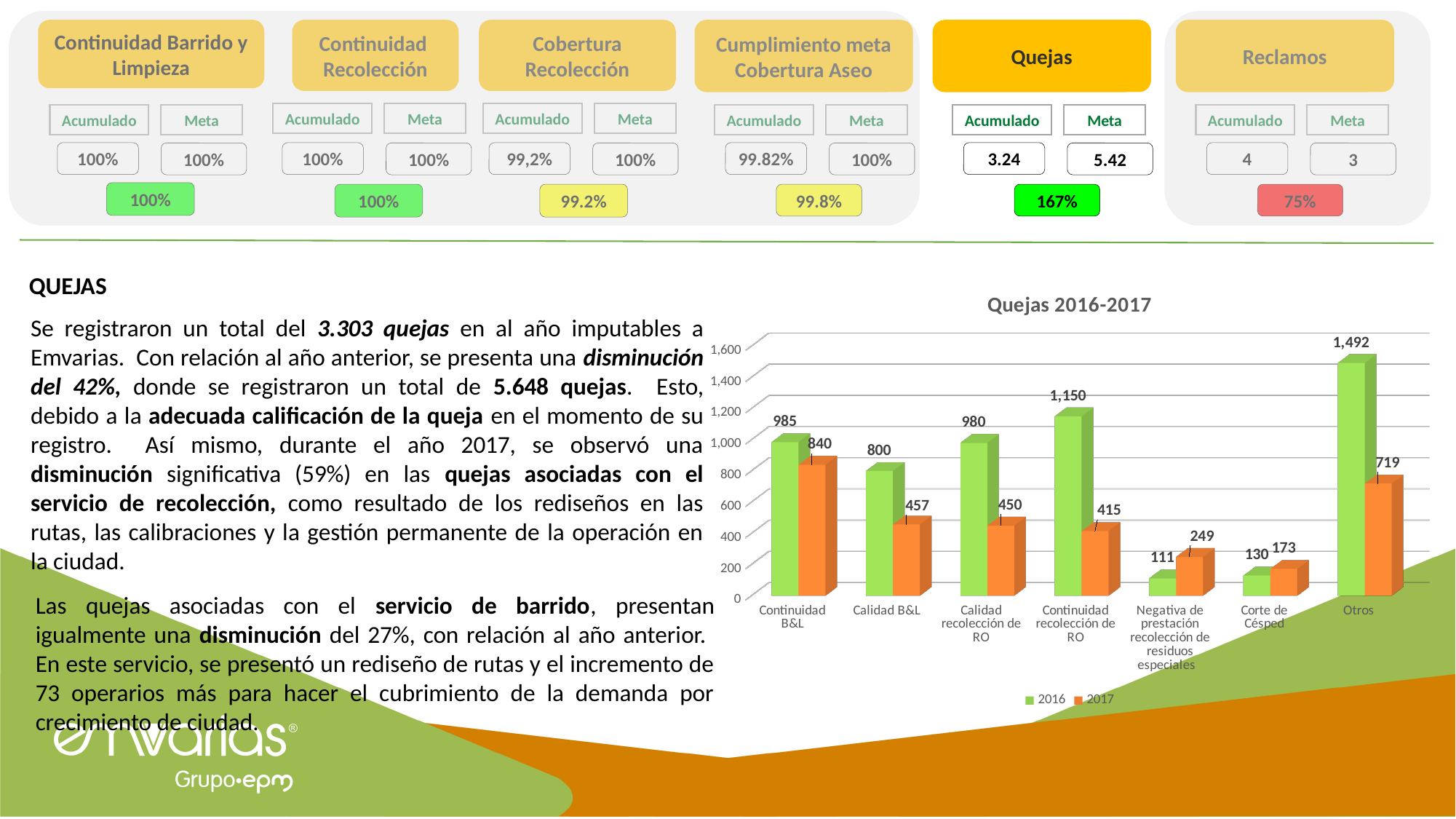
What is the difference between the 2016 values for Otros and Continuidad B&L in the Quejas 2016-2017 chart? 507 Which colour represents the 2017 series in the Quejas 2016-2017 chart? Orange What is the 2017 value for Calidad B&L in the Quejas 2016-2017 chart? 457 What is the 2016 value for Continuidad recolección de RO in the Quejas 2016-2017 chart? 1,150 How many categories are shown on the x axis of the Quejas 2016-2017 chart? 7 In the Quejas 2016-2017 chart, which is larger for Corte de Césped: the 2016 value or the 2017 value? 2017 What is the difference between the 2016 and 2017 values for Continuidad recolección de RO in the Quejas 2016-2017 chart? 735 Which category has the highest 2016 value in the Quejas 2016-2017 chart? Otros How many series does the legend of the Quejas 2016-2017 chart list? 2 What kind of chart is the Quejas 2016-2017 chart? Bar chart What is the 2017 value for Otros in the Quejas 2016-2017 chart? 719 Which category has the lowest 2016 value in the Quejas 2016-2017 chart? Negativa de prestación recolección de residuos especiales